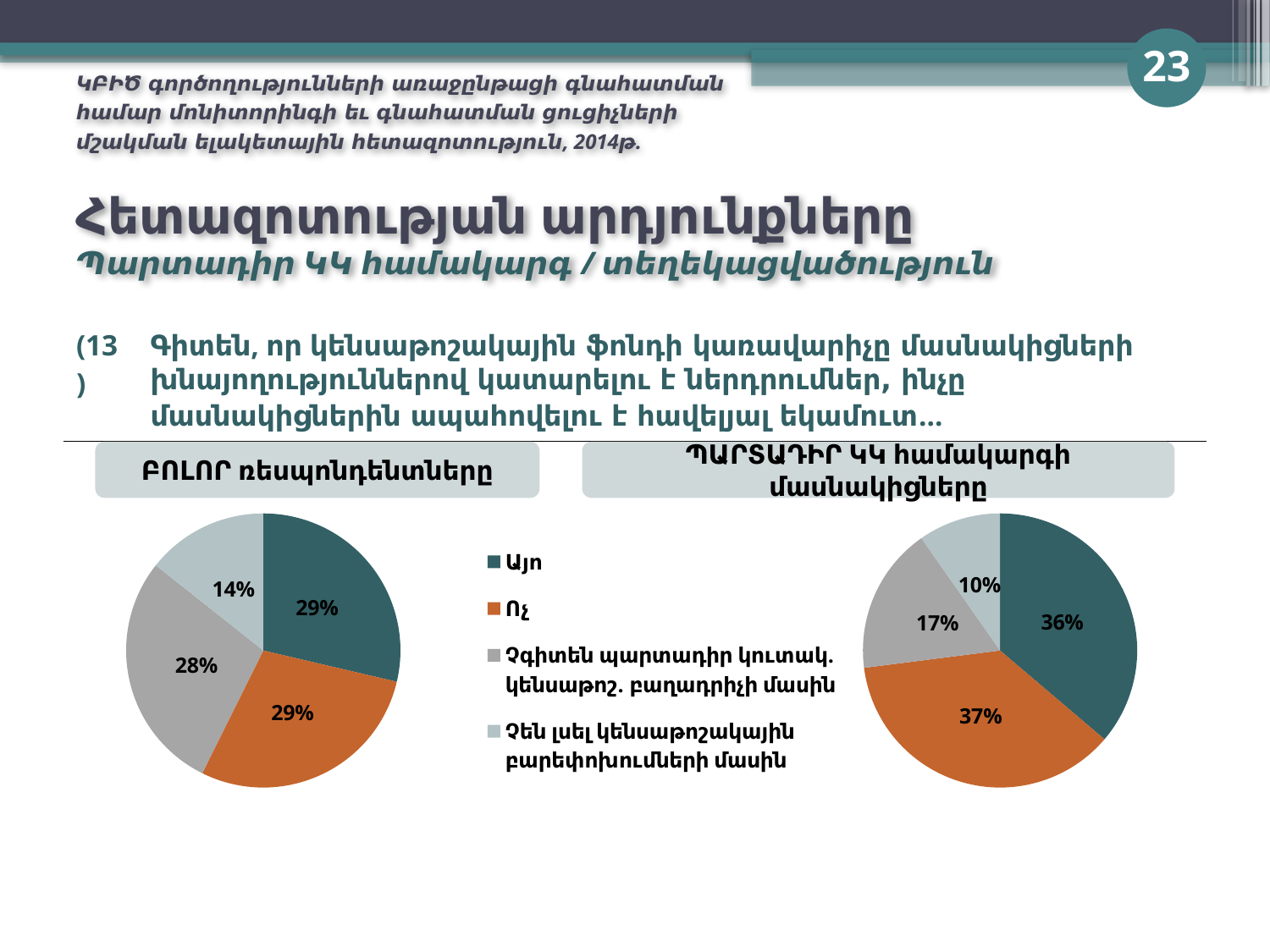
In the right pie chart (ՊԱՐՏԱԴԻՐ ԿԿ համակարգի մասնակիցները), what is the difference between the "Չգիտեն պարտադիր կուտակ. կենսաթոշ. բաղադրիչի մասին" slice and the "Չեն լսել կենսաթոշակային բարեփոխումների մասին" slice? 7% What is the difference between the "Այո" share in the right pie chart (36%) and the "Այո" share in the left pie chart (29%)? 7% In the right pie chart (ՊԱՐՏԱԴԻՐ ԿԿ համակարգի մասնակիցները), what share is labelled for the "Ոչ" slice? 37% In the right pie chart (ՊԱՐՏԱԴԻՐ ԿԿ համակարգի մասնակիցները), what share is labelled for the "Չգիտեն պարտադիր կուտակ. կենսաթոշ. բաղադրիչի մասին" slice? 17% In the left pie chart (ԲՈԼՈՐ ռեսպոնդենտները), what share is labelled for the "Այո" slice? 29% In the left pie chart (ԲՈԼՈՐ ռեսպոնդենտները), which slice is the smallest? Չեն լսել կենսաթոշակային բարեփոխումների մասին Which colour represents the "Ոչ" category in the pie charts? Orange In the right pie chart (ՊԱՐՏԱԴԻՐ ԿԿ համակարգի մասնակիցները), which slice is the smallest? Չեն լսել կենսաթոշակային բարեփոխումների մասին In the left pie chart (ԲՈԼՈՐ ռեսպոնդենտները), what share is labelled for the "Չեն լսել կենսաթոշակային բարեփոխումների մասին" slice? 14% Which is larger: the "Չեն լսել կենսաթոշակային բարեփոխումների մասին" share in the left pie chart or in the right pie chart? Left pie chart (14%) What type of chart is used on this slide? Pie chart How many slices does each pie chart on the slide have? 4